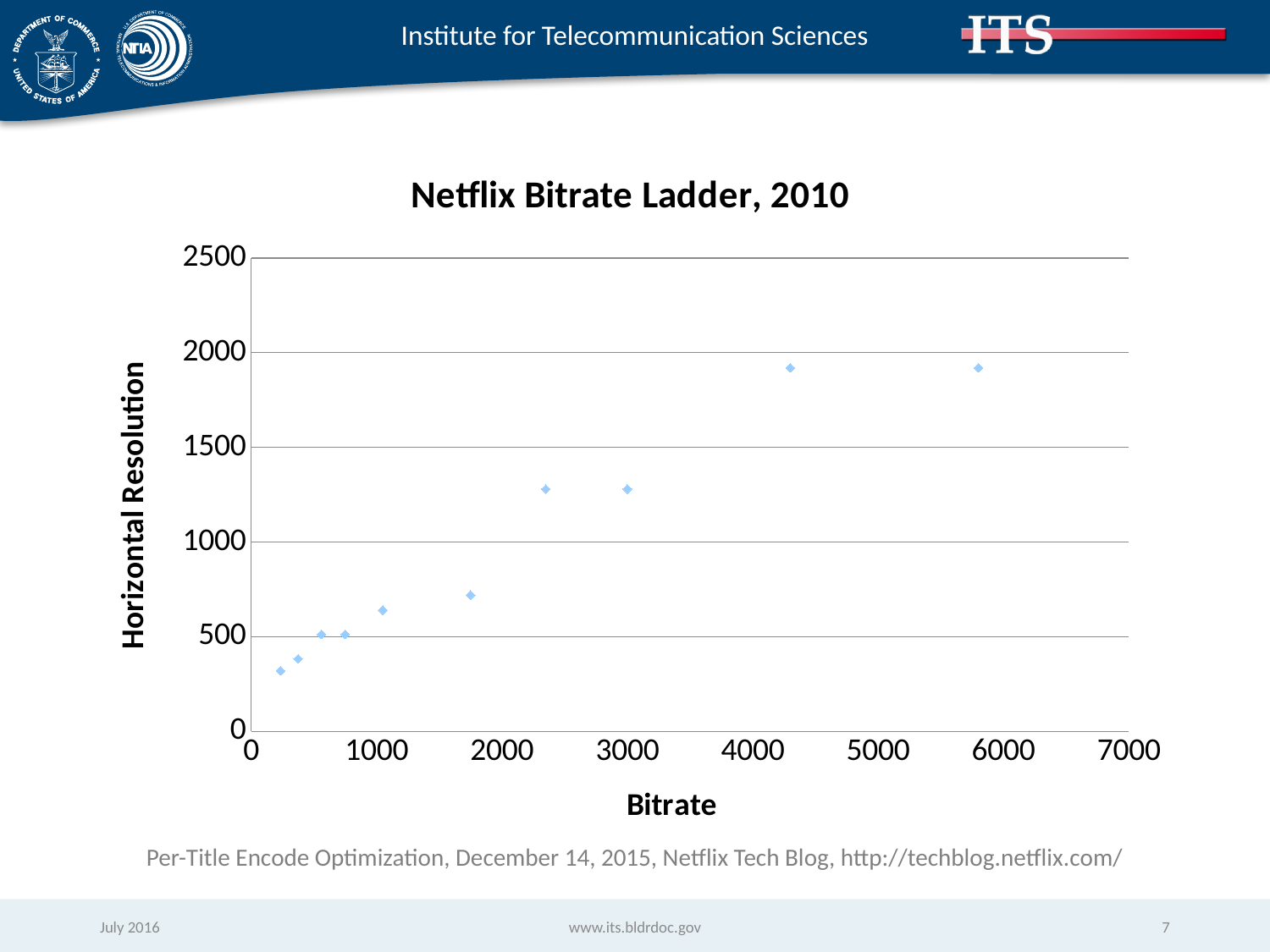
How many data points are plotted on the chart? 10 Which has the higher horizontal resolution: the leftmost point or the rightmost point? the rightmost point What is the title of the chart? Netflix Bitrate Ladder, 2010 Is the horizontal resolution of the point at a bitrate of about 1000 greater or less than 1000? less Is the horizontal resolution of the point at a bitrate of about 3000 greater or less than 1000? greater Is the bitrate of the rightmost point greater or less than 5000? greater What kind of chart is shown on the slide? scatter chart What is the label of the y axis? Horizontal Resolution Do the horizontal resolution values generally rise or fall as bitrate increases along the x axis? rise